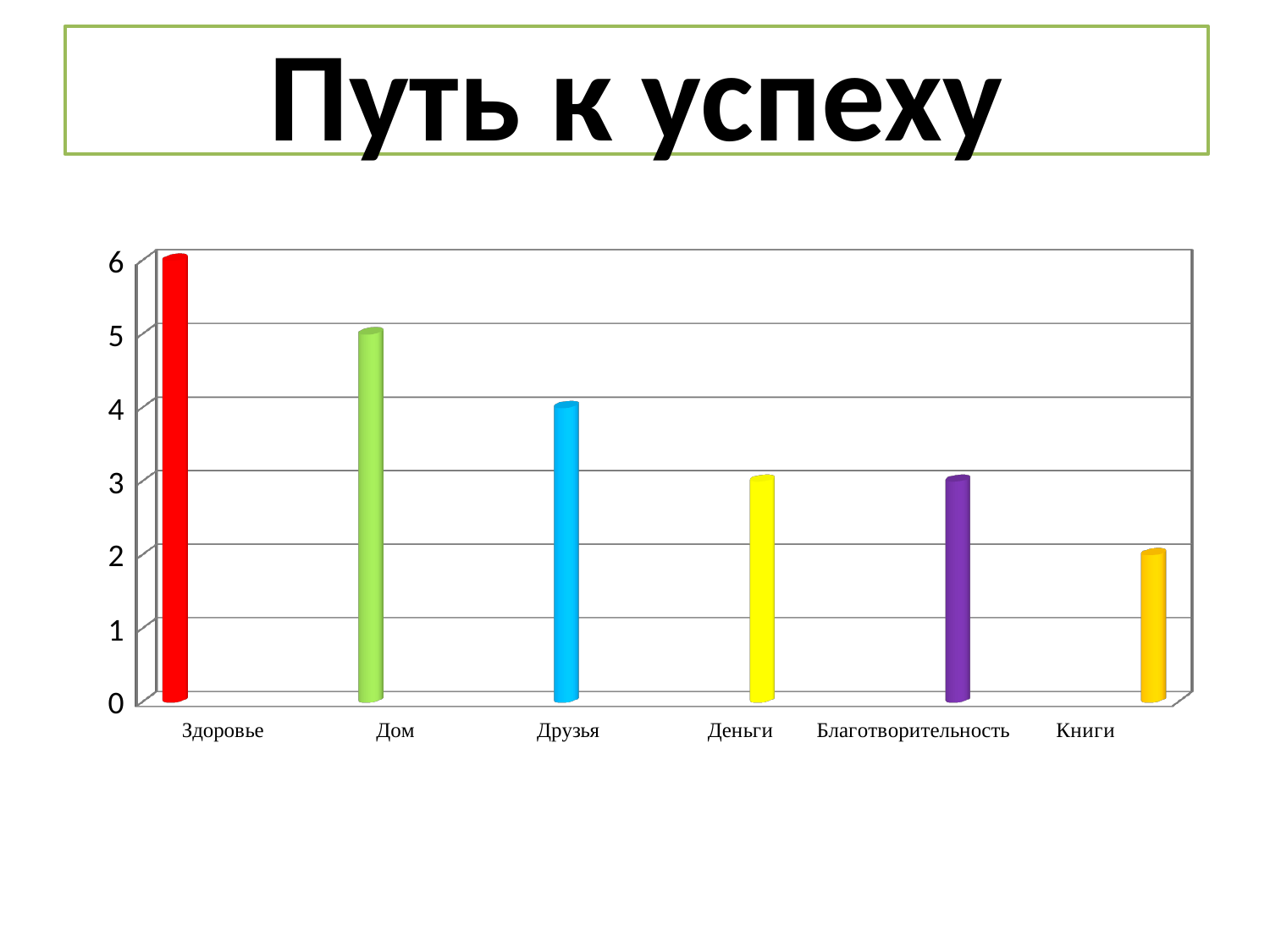
What is the value for Здоровье? 6 Do the values rise or fall from left to right along the x axis? fall What is the value for Дом? 5 What is the difference between the values for Здоровье and Друзья? 2 Which category has the highest value? Здоровье Which category has the lowest value? Книги What is the value for Книги? 2 What kind of chart is shown on the slide? bar chart Is the value for Друзья greater or less than 3? greater Which is larger, the value for Дом or the value for Деньги? Дом How many categories are shown on the x axis? 6 What is the title of the slide? Путь к успеху